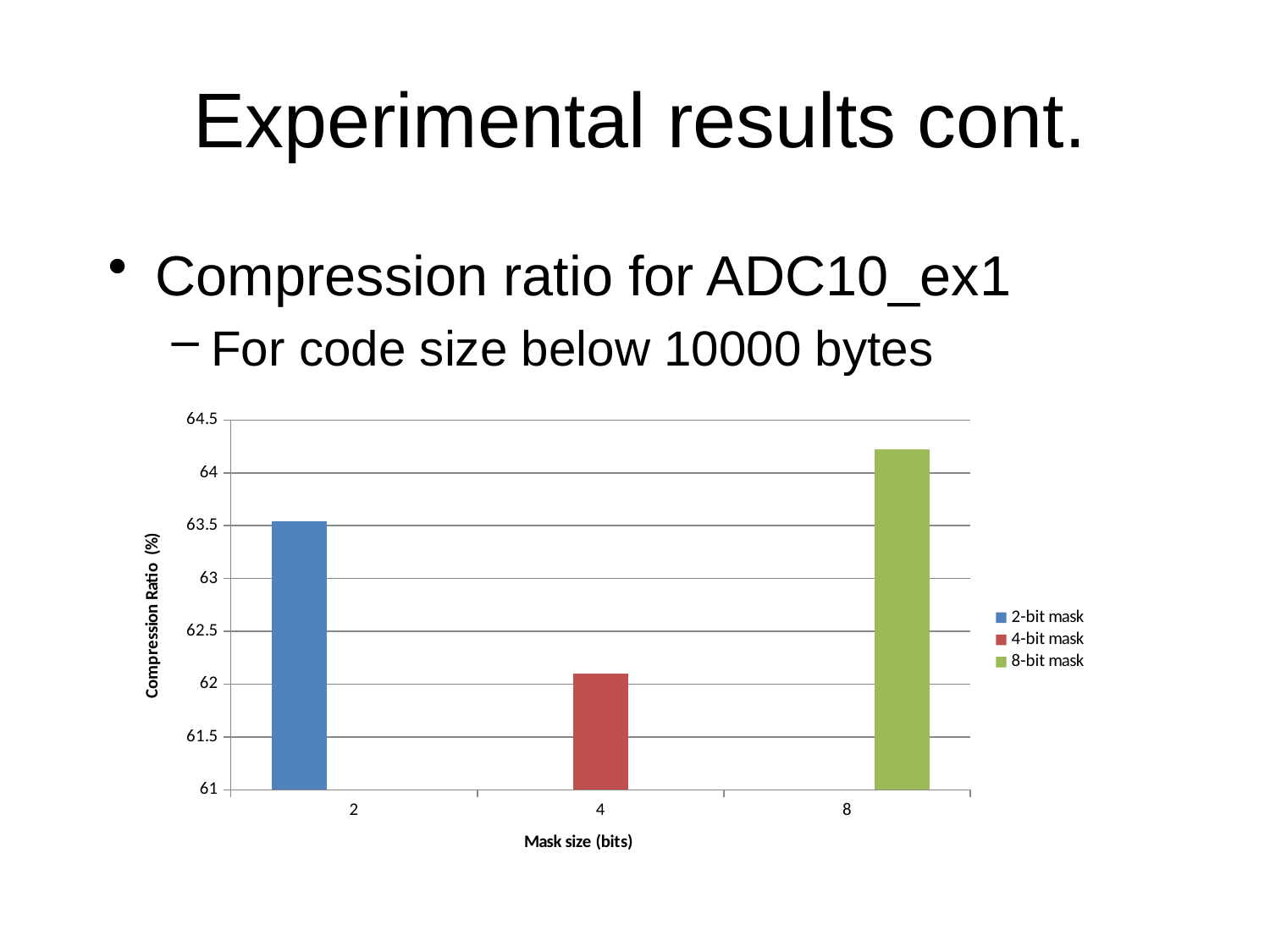
Which mask size has the highest compression ratio? 8 Is the compression ratio for the 8-bit mask greater or less than 64? greater Which has a higher compression ratio, the 2-bit mask or the 4-bit mask? 2-bit mask How many series does the legend list? 3 Which has a higher compression ratio, the 8-bit mask or the 2-bit mask? 8-bit mask How many mask sizes are plotted on the x axis? 3 Is the compression ratio for the 2-bit mask greater or less than 63? greater What kind of chart is shown on the slide? bar chart What is the label of the y axis? Compression Ratio (%) Is the compression ratio for the 2-bit mask greater or less than 64? less Which mask size has the lowest compression ratio? 4